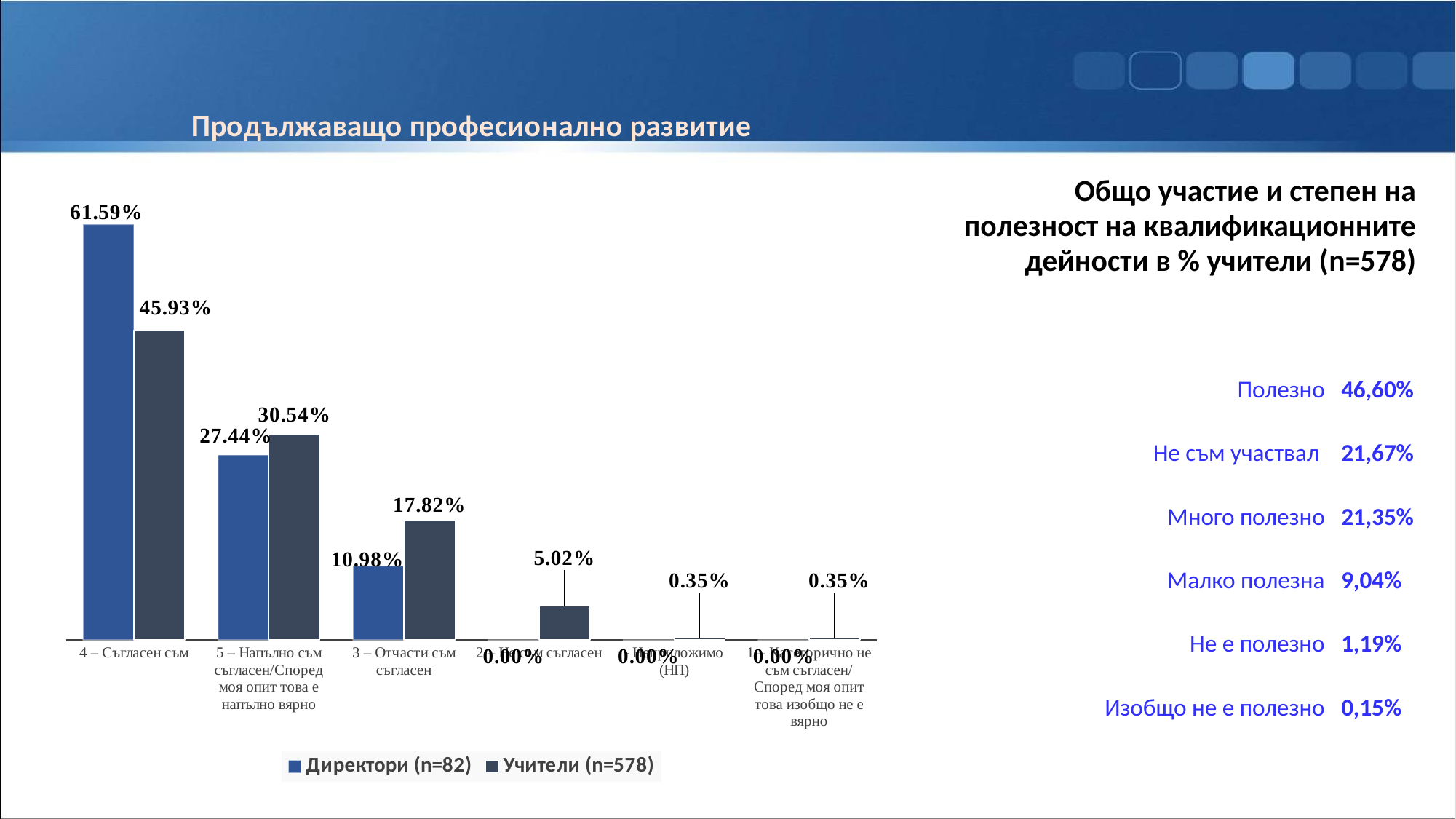
What are the two series named in the chart legend? Директори (n=82) and Учители (n=578) How many series does the chart legend list? 2 What is the value for Учители (n=578) in the category "4 – Съгласен съм"? 45.93% What is the difference between the Учители (n=578) and Директори (n=82) values in the category "5 – Напълно съм съгласен/Според моя опит това е напълно вярно"? 3.10% What is the value for Директори (n=82) in the category "5 – Напълно съм съгласен/Според моя опит това е напълно вярно"? 27.44% In the category "3 – Отчасти съм съгласен", which series has the larger value, Директори (n=82) or Учители (n=578)? Учители (n=578) What is the value for Учители (n=578) in the category "3 – Отчасти съм съгласен"? 17.82% How many categories are shown on the x axis of the chart? 6 What is the difference between the Директори (n=82) and Учители (n=578) values in the category "4 – Съгласен съм"? 15.66% Which category has the highest value for Учители (n=578)? 4 – Съгласен съм What kind of chart is shown on the slide? bar chart What is the value for Директори (n=82) in the category "4 – Съгласен съм"? 61.59%